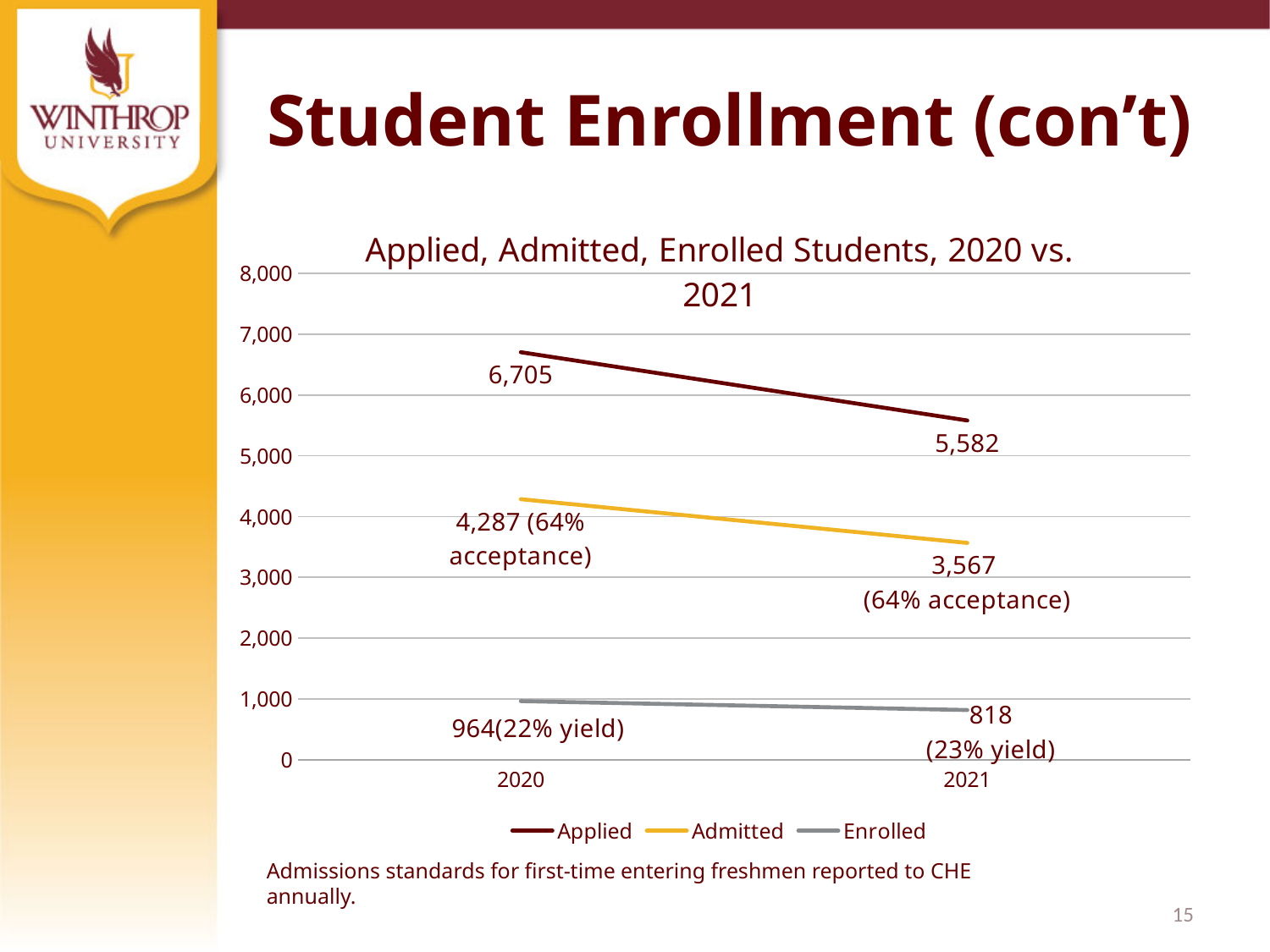
What is the yield percentage shown for Enrolled students in 2021? 23% What is the number of Applied students in 2021? 5,582 What is the title of the chart? Applied, Admitted, Enrolled Students, 2020 vs. 2021 What is the difference between Admitted students in 2020 and 2021? 720 What is the number of Admitted students in 2021? 3,567 By how much did the number of Applied students decrease from 2020 to 2021? 1,123 Which series has the lowest values in the chart? Enrolled What is the number of Enrolled students in 2020? 964 How many series does the legend list? 3 Does the Applied series rise or fall from 2020 to 2021? Fall What is the number of Applied students in 2020? 6,705 What kind of chart is shown on the slide? Line chart